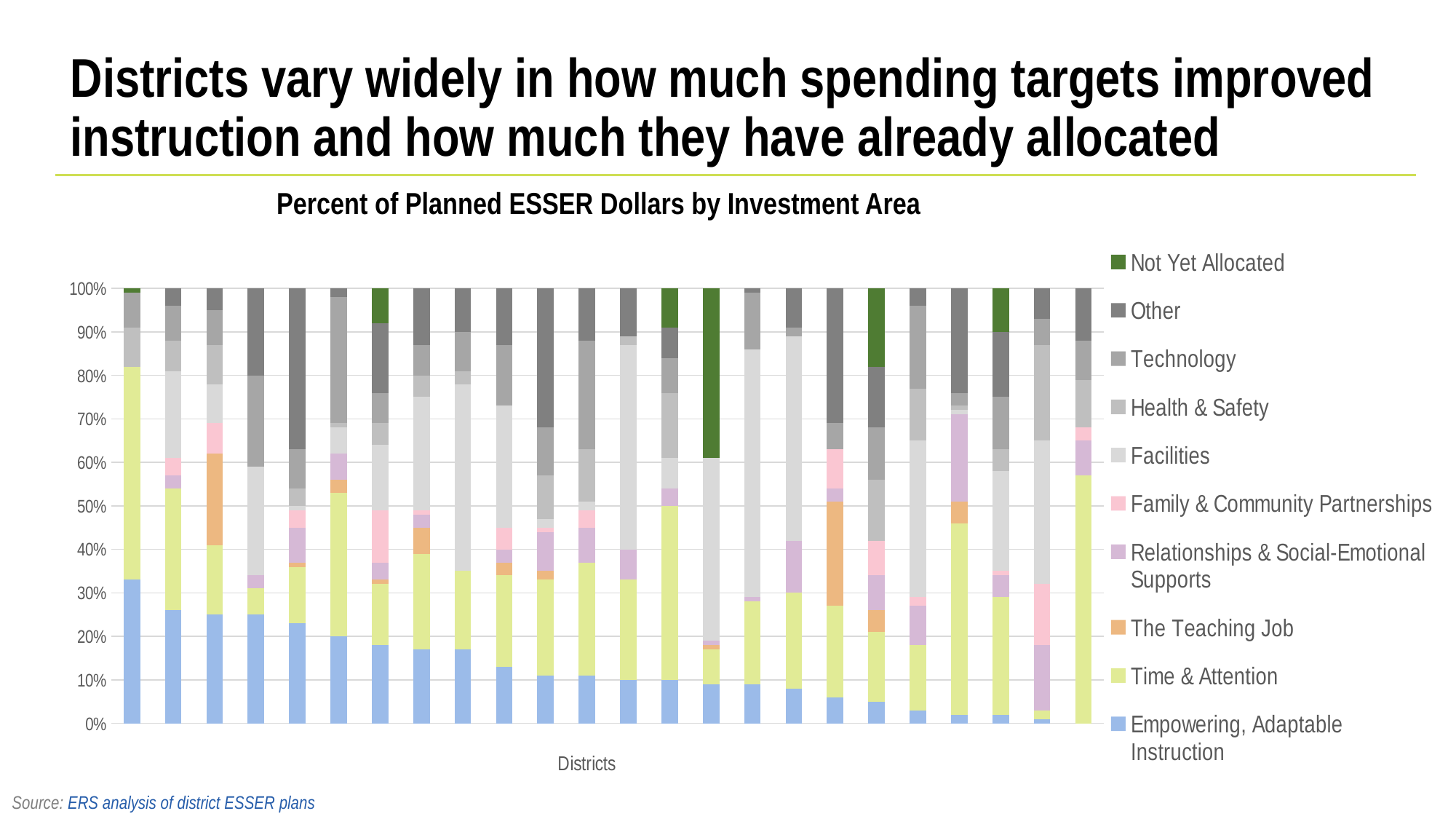
What is the label on the x axis of the chart? Districts Which series is shown at the bottom of each stacked bar? Empowering, Adaptable Instruction Which district has the largest Empowering, Adaptable Instruction share, the leftmost or the rightmost? Leftmost Does the Empowering, Adaptable Instruction share rise or fall across the districts from left to right? Fall What is the highest value shown on the y axis? 100% How many series does the legend list? 10 What kind of chart is shown on the slide? Stacked bar chart Is the Empowering, Adaptable Instruction value for the rightmost district greater or less than 10%? less Is the Empowering, Adaptable Instruction value for the leftmost district greater or less than 20%? greater What is the total height of each stacked bar? 100% How many district bars are plotted in the chart? 24